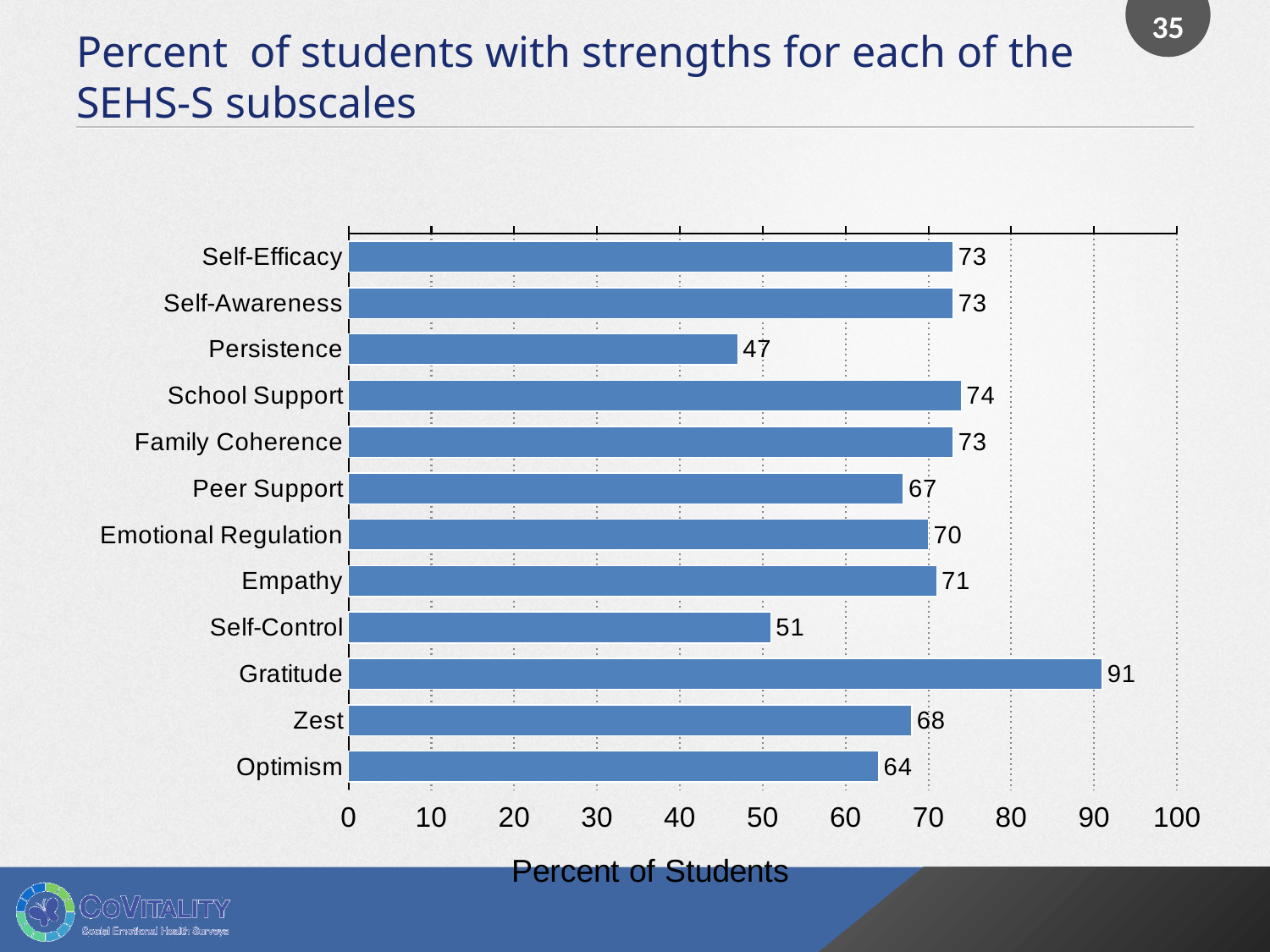
How many subscales are shown in the chart? 12 What is the value for Gratitude? 91 What is the difference between the values for School Support and Peer Support? 7 What is the value for Persistence? 47 What is the label of the horizontal axis? Percent of Students What is the value for Emotional Regulation? 70 Which subscale has the lowest percent of students with strengths? Persistence Which subscale has the highest percent of students with strengths? Gratitude What is the difference between the values for Gratitude and Self-Control? 40 What kind of chart is shown on the slide? Bar chart What is the value for Optimism? 64 Which is larger, the value for Zest or the value for Optimism? Zest